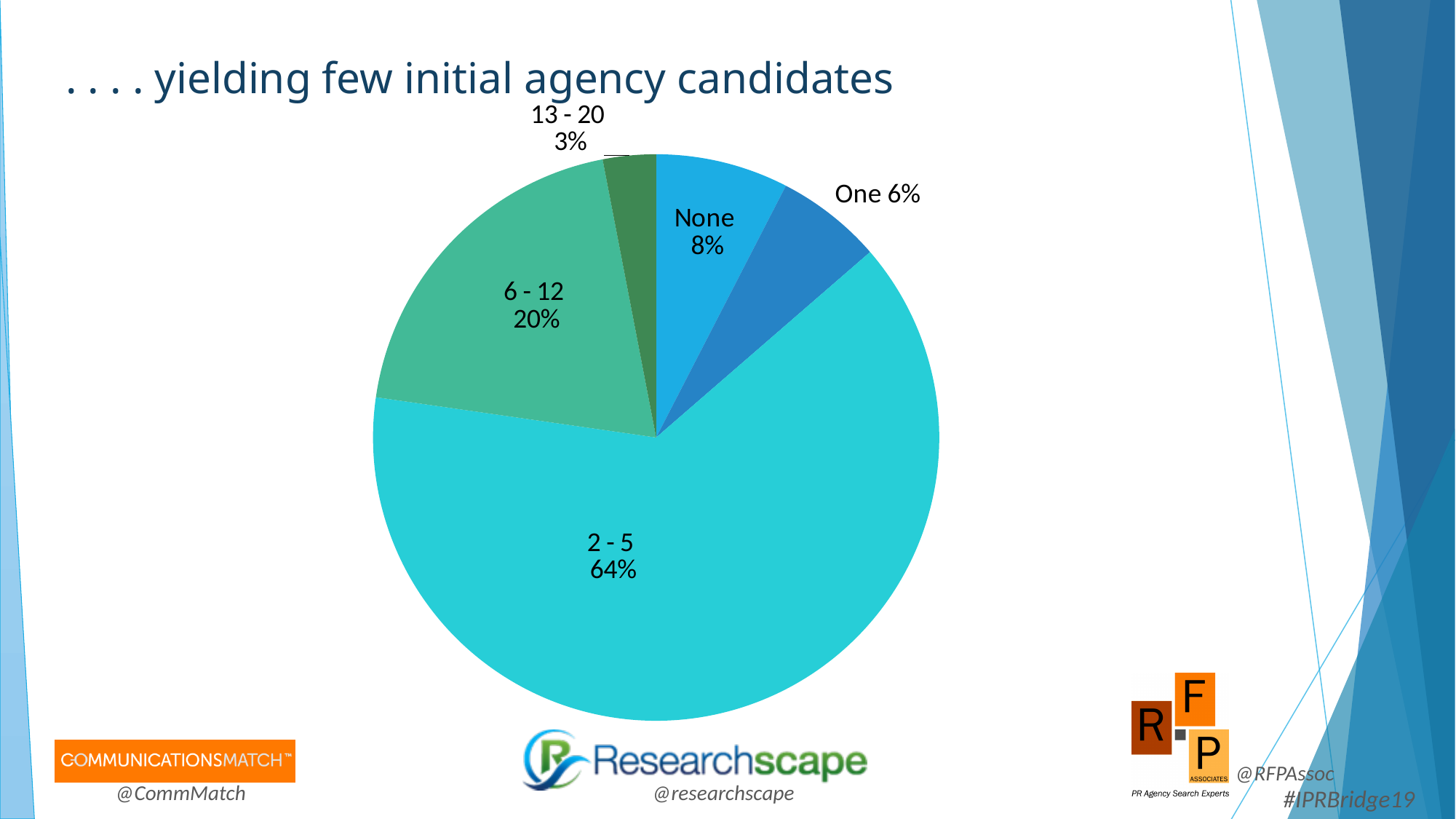
What is the difference between the "2 - 5" slice and the "6 - 12" slice? 44% What is the value for the "One" slice? 6% Which category has the smallest slice of the pie? 13 - 20 What is the value for the "13 - 20" slice? 3% How many slices does the pie chart have? 5 What share of the pie does the "2 - 5" slice represent? 64% What is the value for the "6 - 12" slice? 20% What kind of chart is shown on the slide? pie chart Which is larger, the "None" slice or the "One" slice? None What is the value for the "None" slice? 8% Which category has the largest slice of the pie? 2 - 5 What is the title of the slide containing the pie chart? . . . . yielding few initial agency candidates